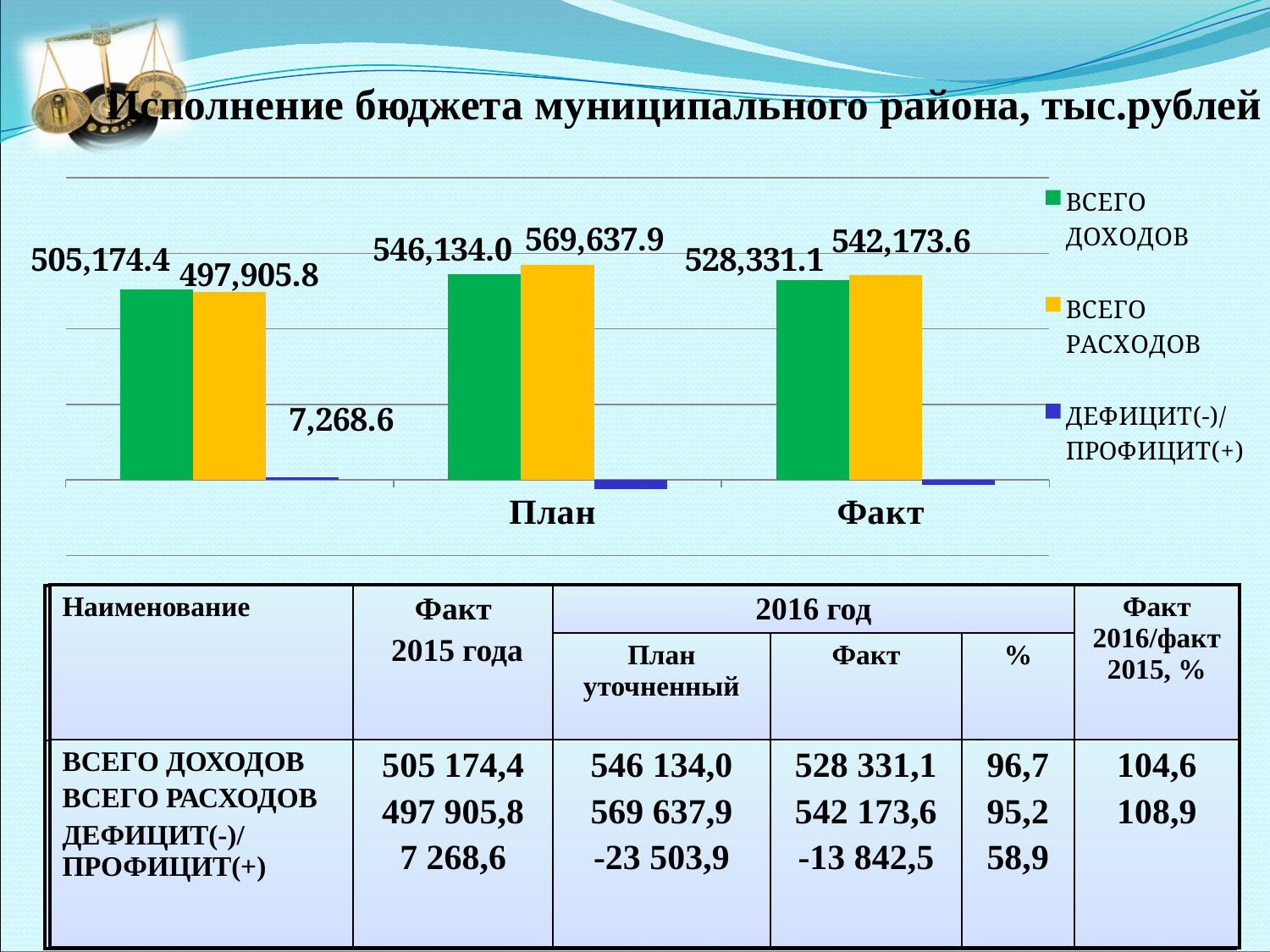
What is the value of ВСЕГО ДОХОДОВ for План? 546,134.0 For План, how much larger is ВСЕГО РАСХОДОВ than ВСЕГО ДОХОДОВ? 23,503.9 For План, which is larger: ВСЕГО ДОХОДОВ or ВСЕГО РАСХОДОВ? ВСЕГО РАСХОДОВ What is the value of ВСЕГО ДОХОДОВ for Факт? 528,331.1 What colour represents ВСЕГО ДОХОДОВ in the chart? Green What is the value of ВСЕГО РАСХОДОВ for План? 569,637.9 Of План and Факт, which has the higher ВСЕГО РАСХОДОВ? План What kind of chart is shown on the slide? Bar chart What is the value of ВСЕГО РАСХОДОВ for Факт? 542,173.6 For Факт, what is the difference between ВСЕГО РАСХОДОВ and ВСЕГО ДОХОДОВ? 13,842.5 What is the data label on the ДЕФИЦИТ(-)/ПРОФИЦИТ(+) bar in the leftmost group of bars? 7,268.6 How many series does the chart legend list? 3